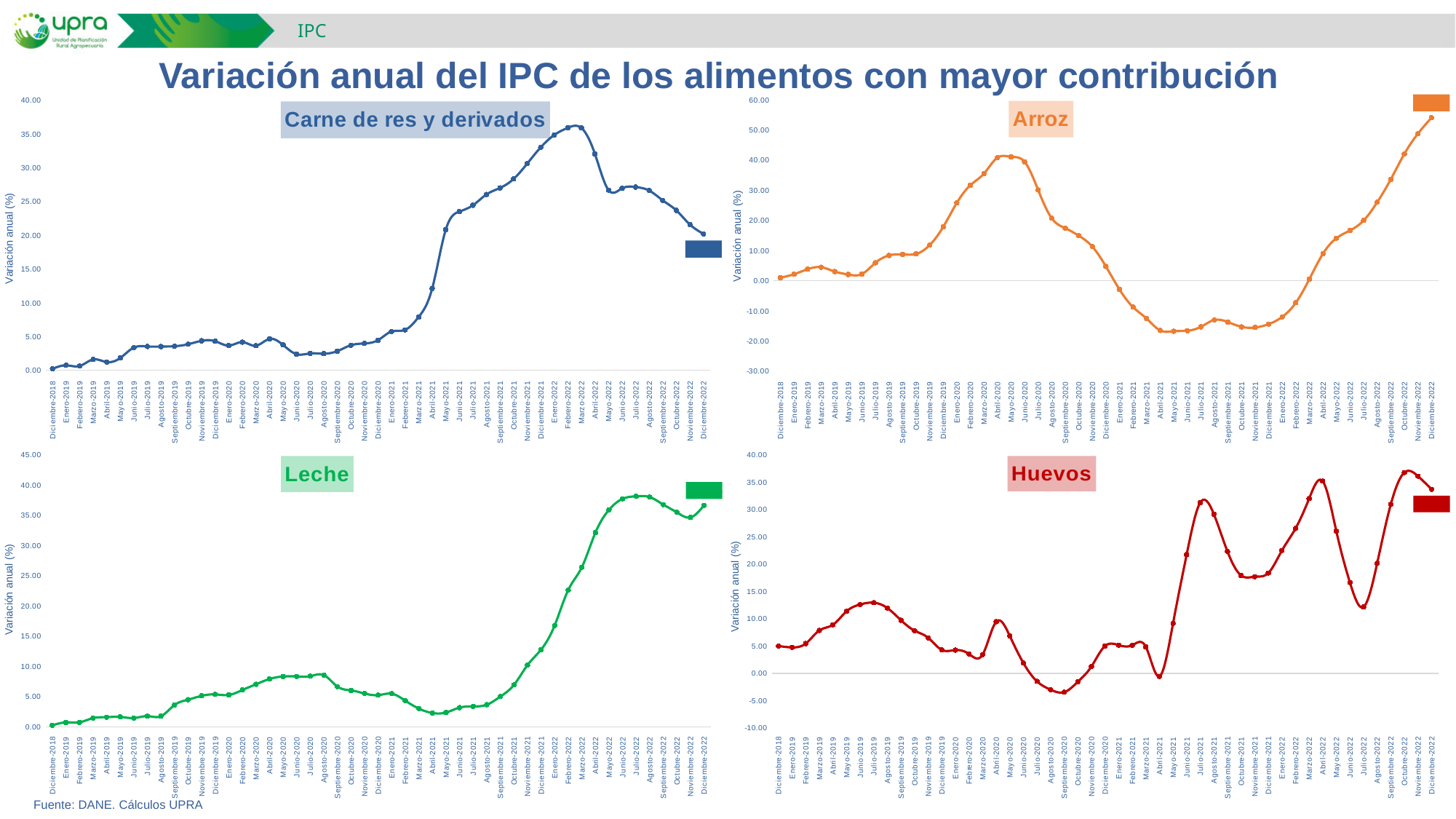
In the 'Huevos' chart, is the value for Octubre-2022 greater or less than 30.00? greater In the 'Carne de res y derivados' chart, is the value for Febrero-2022 greater or less than 30.00? greater What is the title of the slide? Variación anual del IPC de los alimentos con mayor contribución In the 'Leche' chart, do the values rise or fall between Marzo-2021 and Julio-2022? rise In the 'Carne de res y derivados' chart, which is larger: the value for Febrero-2022 or the value for Diciembre-2022? Febrero-2022 What kind of chart is used for 'Carne de res y derivados'? Line chart In the 'Leche' chart, is the value for Abril-2021 greater or less than 5.00? less How many charts are shown on the slide? 4